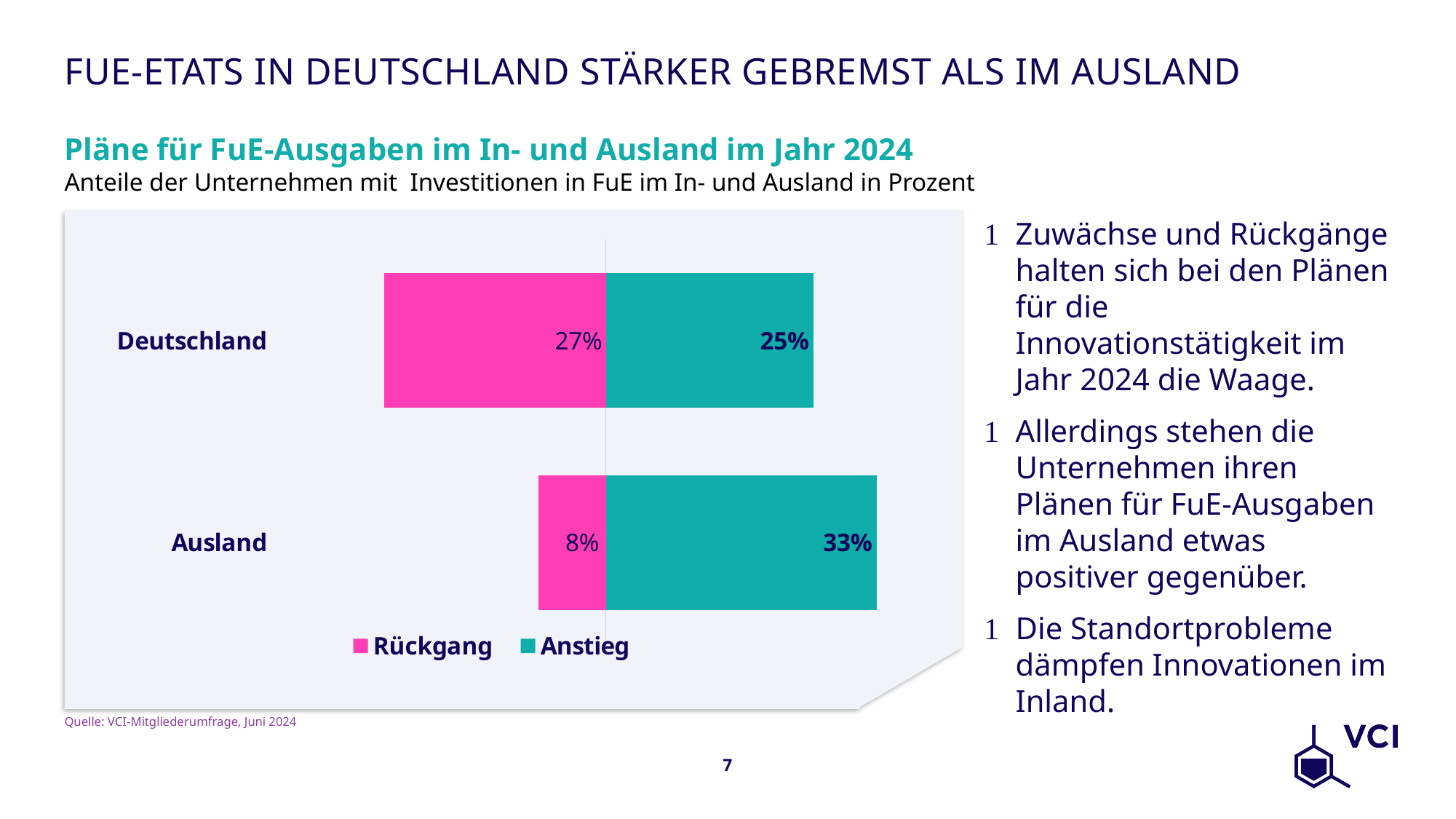
Which category has the lower Rückgang value? Ausland Which category has the higher Anstieg value? Ausland What is the Rückgang value for Ausland? 8% What is the difference between the Anstieg values for Ausland and Deutschland? 8 percentage points Is the Rückgang value for Deutschland larger or smaller than the Anstieg value for Deutschland? larger What kind of chart is shown on the slide? bar chart How many series does the legend list? 2 What is the Rückgang value for Deutschland? 27% What is the difference between the Rückgang values for Deutschland and Ausland? 19 percentage points What is the Anstieg value for Ausland? 33% What is the Anstieg value for Deutschland? 25% How many categories are shown on the chart? 2